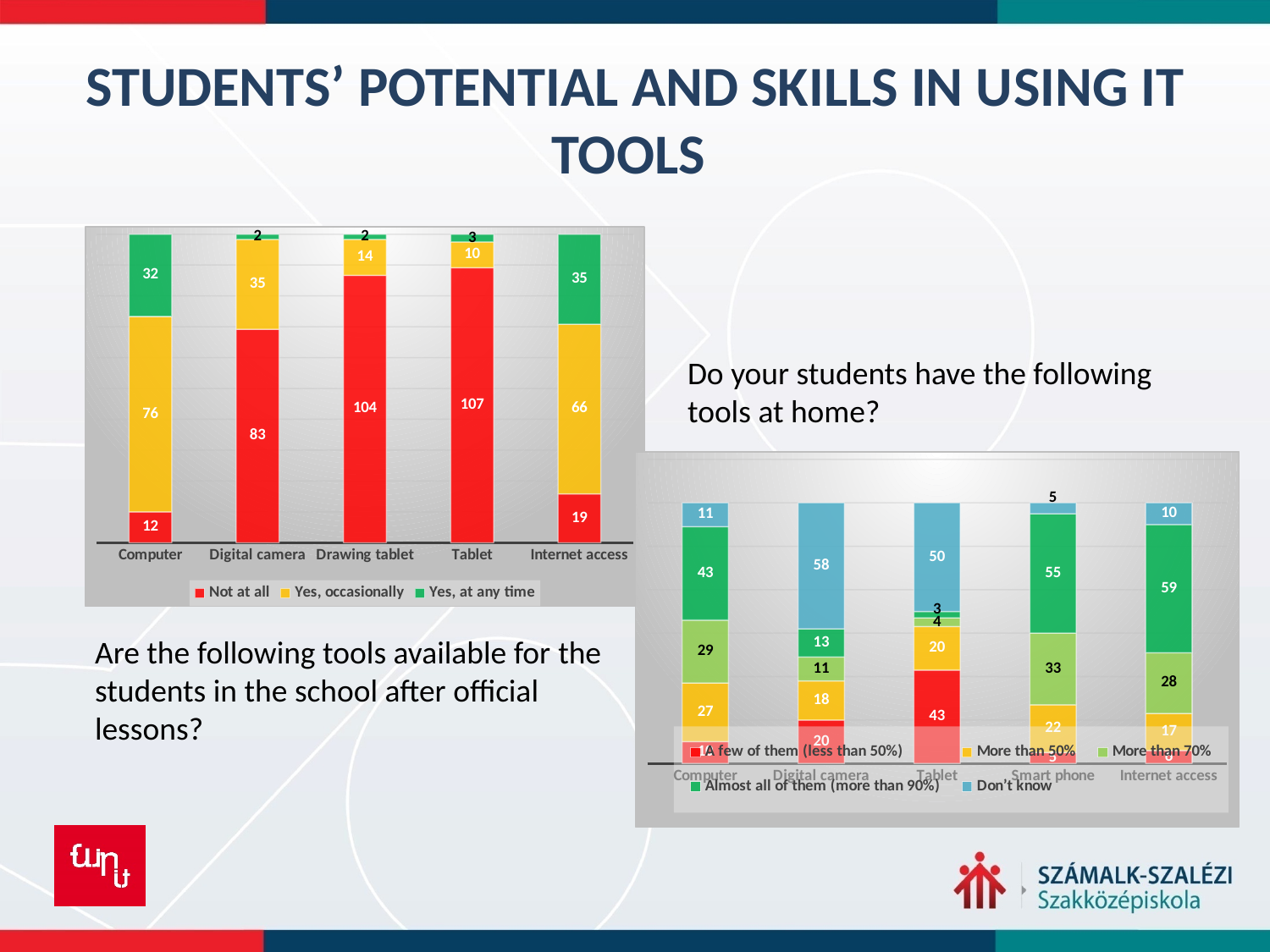
In the left chart (tools available in school after lessons), what is the difference between the 'Not at all' values for Drawing tablet and Digital camera? 21 In the right chart (tools students have at home), which is larger: the 'A few of them (less than 50%)' value for Tablet or for Digital camera? Tablet In the left chart (tools available in school after lessons), what is the total of the stacked bar for Internet access? 120 In the right chart (tools students have at home), how many categories are shown on the x axis? 5 In the right chart (tools students have at home), what is the 'Almost all of them (more than 90%)' value for Internet access? 59 What type of chart is the right chart (tools students have at home)? Stacked bar chart In the left chart (tools available in school after lessons), which category has the lowest 'Not at all' value? Computer In the left chart (tools available in school after lessons), what is the 'Yes, occasionally' value for Computer? 76 In the right chart (tools students have at home), what is the 'Don't know' value for Digital camera? 58 In the left chart (tools available in school after lessons), which category has the highest 'Not at all' value? Tablet In the left chart (tools available in school after lessons), how many series does the legend list? 3 In the left chart (tools available in school after lessons), what is the 'Not at all' value for Tablet? 107